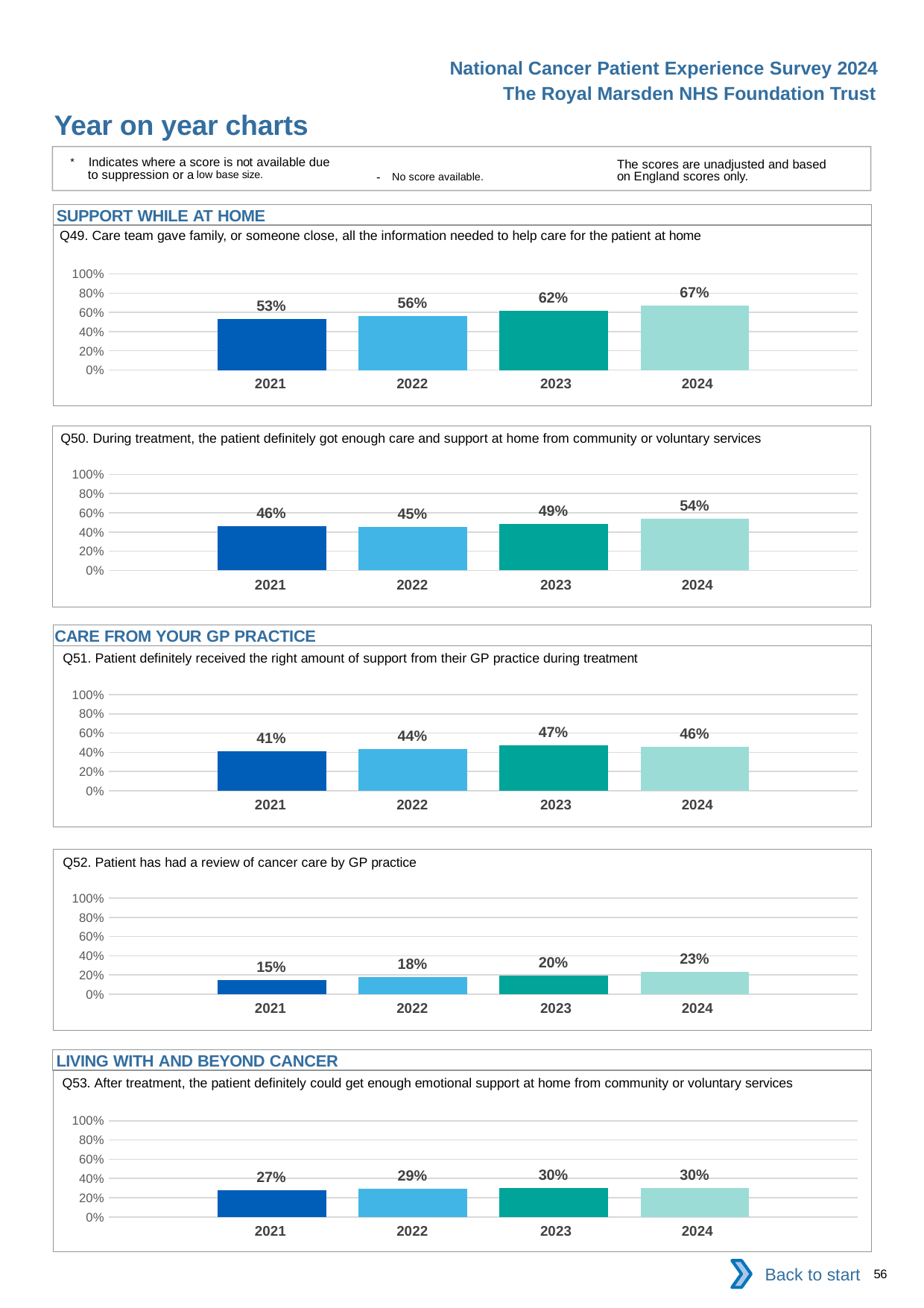
In the Q52 chart, how many years are plotted? 4 Which section heading appears above the Q51 chart? CARE FROM YOUR GP PRACTICE In the Q51 chart, which year has the highest value? 2023 In the Q50 chart, what is the difference between the 2024 and 2023 values? 5% In the Q49 chart, do the values rise or fall from 2021 to 2024? rise In the Q53 chart, what is the value for 2023? 30% In the Q53 chart, which is larger, the value for 2021 or the value for 2022? 2022 In the Q51 chart, what is the difference between the 2023 and 2021 values? 6% In the Q52 chart, what is the value for 2021? 15% In the Q49 chart, what is the value for 2024? 67% What kind of chart is the Q50 chart? bar chart In the Q50 chart, which year has the lowest value? 2022